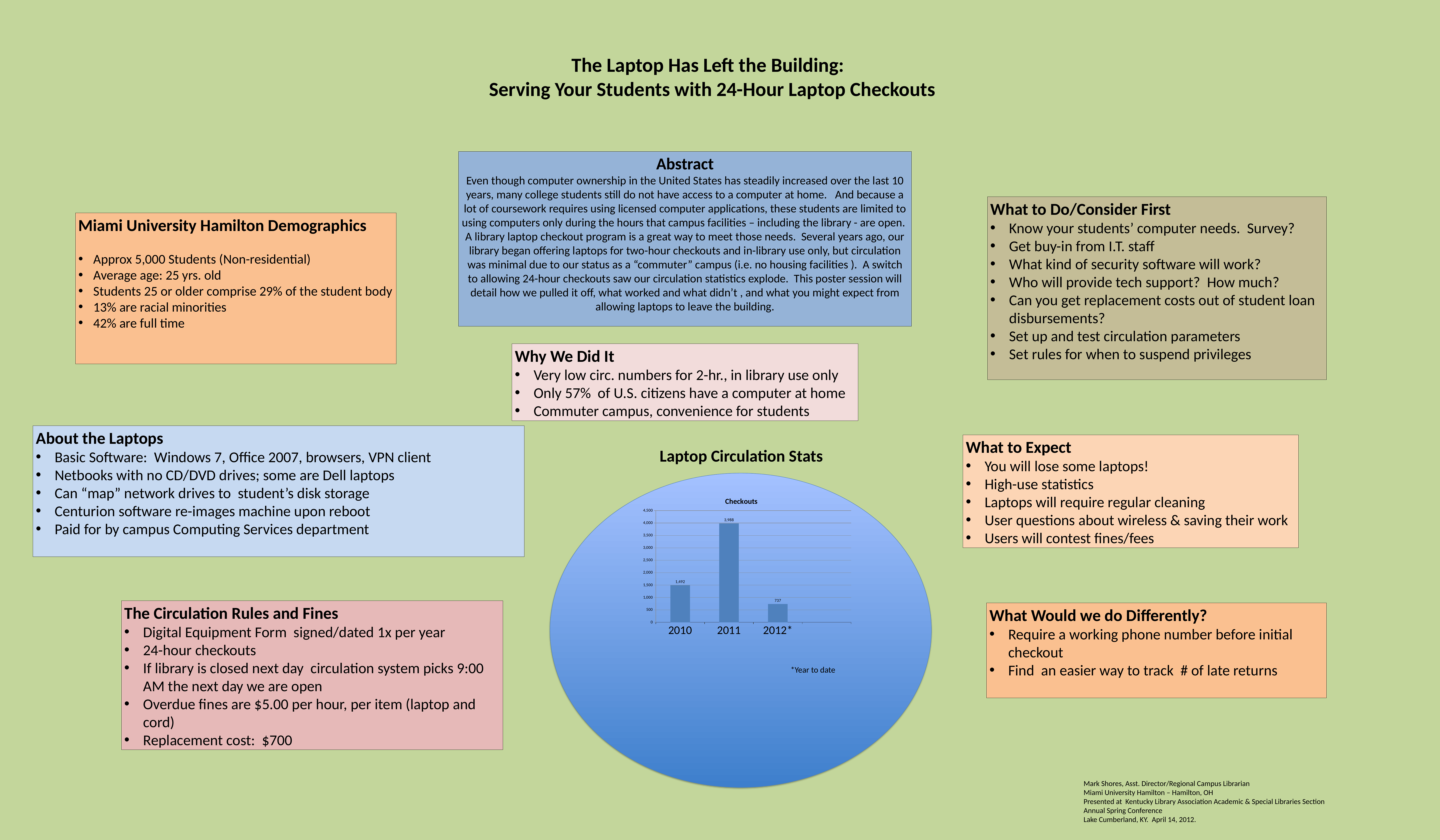
What is the number of checkouts for 2010? 1,492 What kind of chart is used to show the checkouts? bar chart Which year has more checkouts, 2010 or 2012*? 2010 How many years are shown on the chart? 3 Which year has the highest number of checkouts? 2011 Which year has the lowest number of checkouts? 2012* What is the title of the chart? Checkouts What is the number of checkouts for 2011? 3,988 What is the number of checkouts for 2012*? 737 Is the value for 2011 greater or less than 3,500? greater What is the difference in checkouts between 2011 and 2010? 2,496 What is the difference in checkouts between 2010 and 2012*? 755